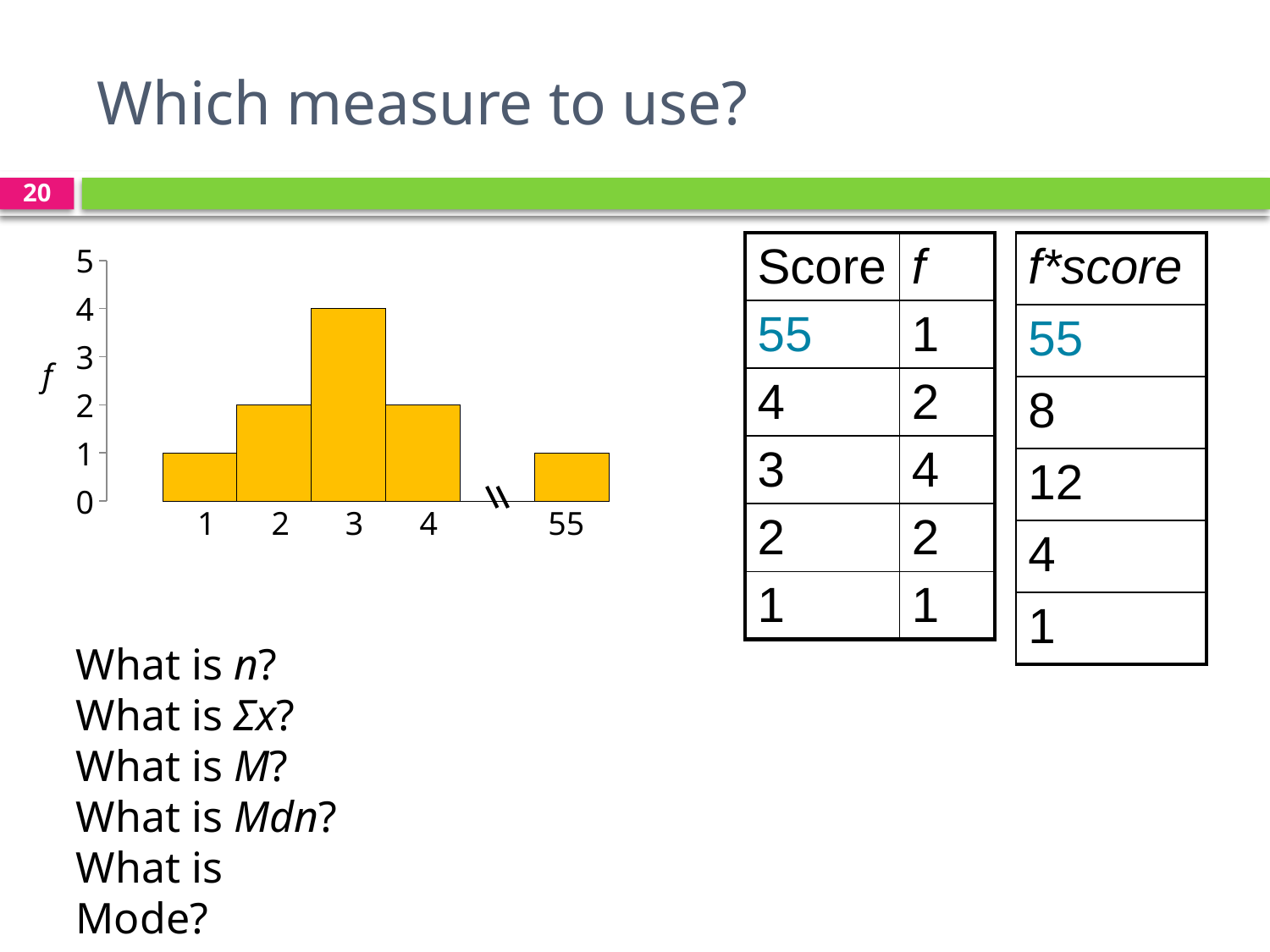
What is the frequency (f) for a score of 55 in the chart? 1 What is the highest value shown on the y axis of the chart? 5 Is the frequency for score 3 greater or less than 2? greater What kind of chart is shown on the slide? bar chart What is the difference between the frequency for score 3 and the frequency for score 4? 2 What is the frequency (f) for a score of 3 in the chart? 4 What is the frequency (f) for a score of 2 in the chart? 2 How many bars are plotted in the chart? 5 Which has a larger frequency in the chart, score 2 or score 3? 3 What label is shown on the y axis of the chart? f Do the frequencies rise or fall from score 1 to score 3 along the x axis? rise Which score has the highest frequency in the chart? 3